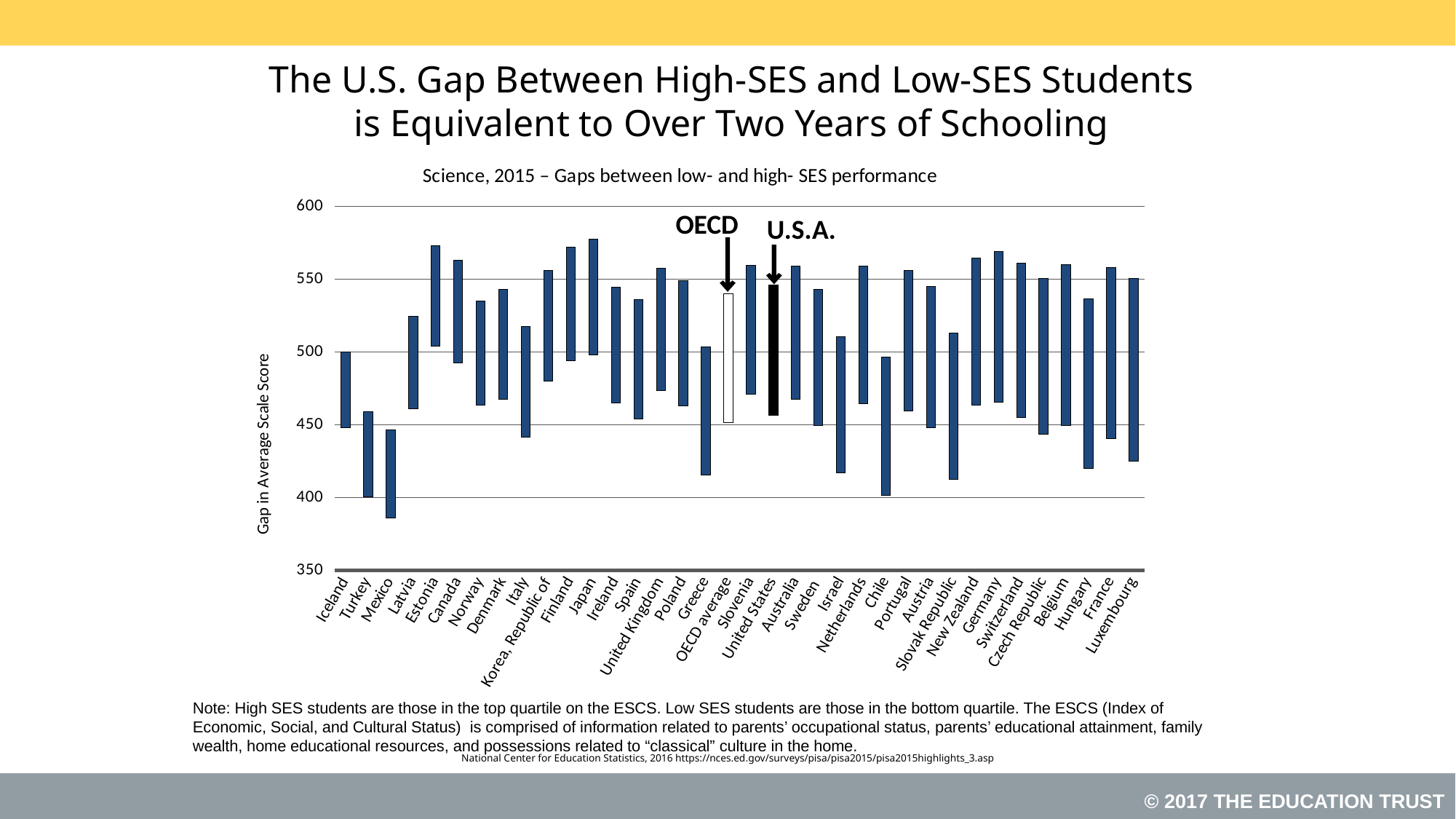
Is the bottom of the bar for Luxembourg greater or less than 450? less What is the title of the chart? Science, 2015 – Gaps between low- and high- SES performance What kind of chart is shown on the slide? Bar chart Which country's bar reaches the highest point on the chart? Japan Which bar reaches a higher top value, Iceland or Mexico? Iceland What is the label on the vertical axis of the chart? Gap in Average Scale Score Is the top of the bar for Japan greater or less than 550? greater Is the bottom of the bar for Mexico greater or less than 400? less How many countries or groups are shown along the x axis of the chart? 36 Which country's bar reaches the lowest point on the chart? Mexico